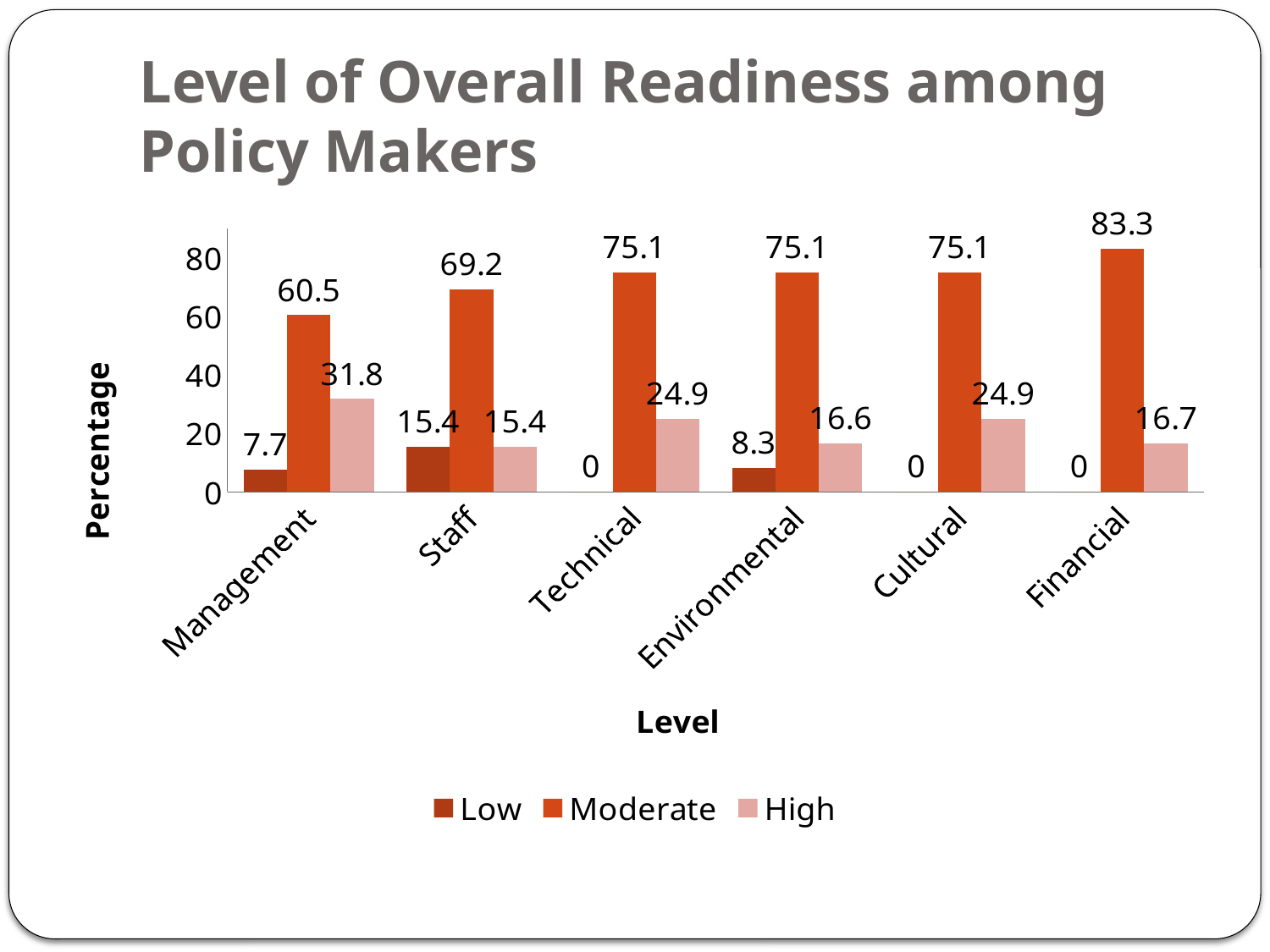
What is the Low value for Staff? 15.4 How many categories are shown on the x axis? 6 Which category has the lowest Moderate value? Management What is the High value for Technical? 24.9 What is the label of the vertical axis? Percentage What is the difference between the Moderate values for Financial and Staff? 14.1 Which is larger, the High value for Cultural or the High value for Environmental? Cultural Which category has the highest Moderate value? Financial What kind of chart is shown? Bar chart How many series does the legend list? 3 Which category has the highest High value? Management What is the Moderate value for Management? 60.5